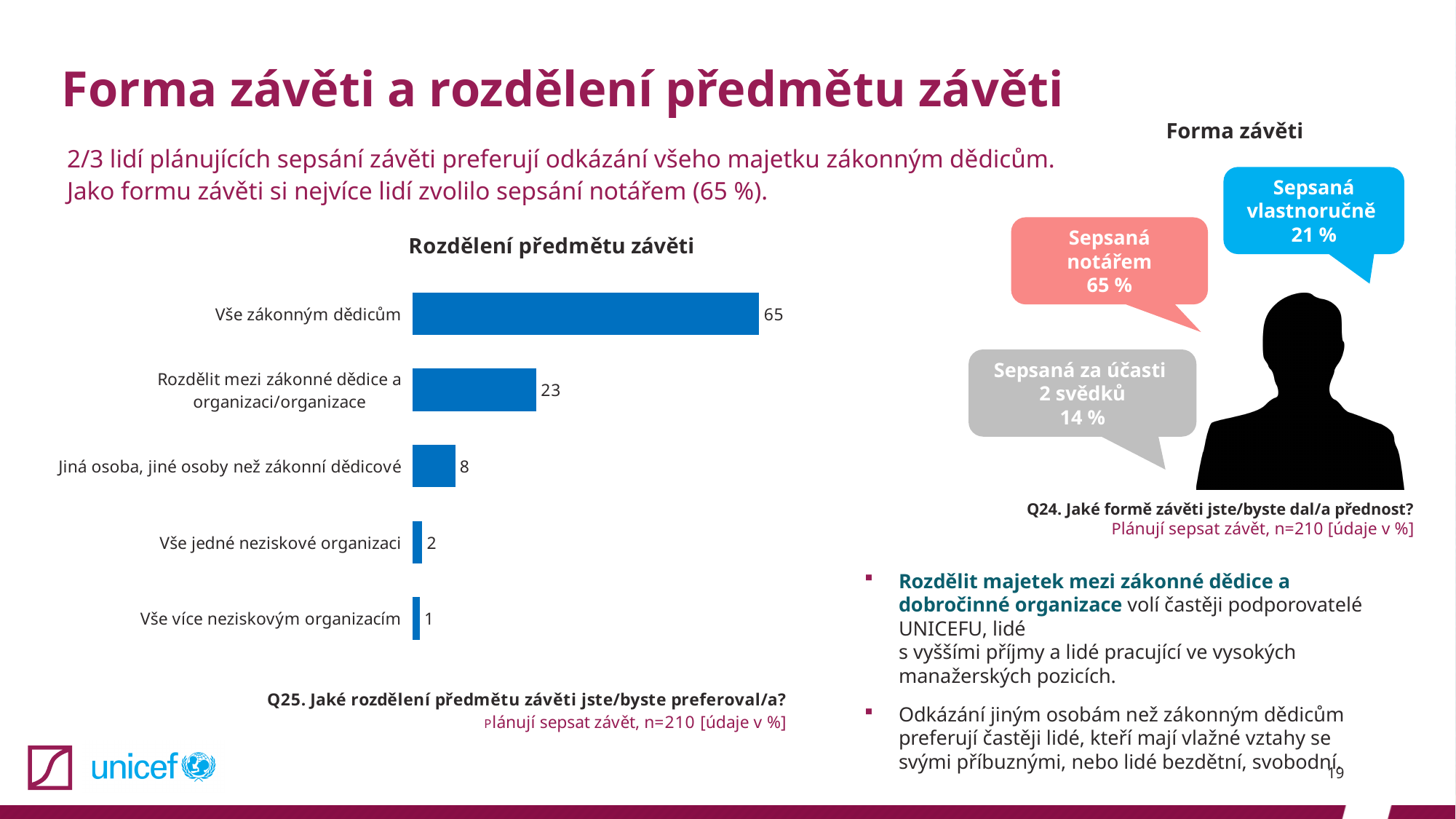
What type of chart is 'Rozdělení předmětu závěti'? Bar chart In the chart 'Rozdělení předmětu závěti', what is the value for 'Vše více neziskovým organizacím'? 1 In the chart 'Rozdělení předmětu závěti', what is the value for 'Jiná osoba, jiné osoby než zákonní dědicové'? 8 How many categories are shown in the chart 'Rozdělení předmětu závěti'? 5 In the chart 'Rozdělení předmětu závěti', what is the value for 'Rozdělit mezi zákonné dědice a organizaci/organizace'? 23 In the chart 'Rozdělení předmětu závěti', what is the difference between the values for 'Vše zákonným dědicům' and 'Rozdělit mezi zákonné dědice a organizaci/organizace'? 42 What is the title of the bar chart on the left side of the slide? Rozdělení předmětu závěti In the chart 'Rozdělení předmětu závěti', what is the value for 'Vše zákonným dědicům'? 65 In the chart 'Rozdělení předmětu závěti', which category has the lowest value? Vše více neziskovým organizacím In the 'Forma závěti' graphic, what percentage is shown for 'Sepsaná vlastnoručně'? 21 % In the chart 'Rozdělení předmětu závěti', which is larger: 'Jiná osoba, jiné osoby než zákonní dědicové' or 'Vše jedné neziskové organizaci'? Jiná osoba, jiné osoby než zákonní dědicové In the chart 'Rozdělení předmětu závěti', which category has the highest value? Vše zákonným dědicům